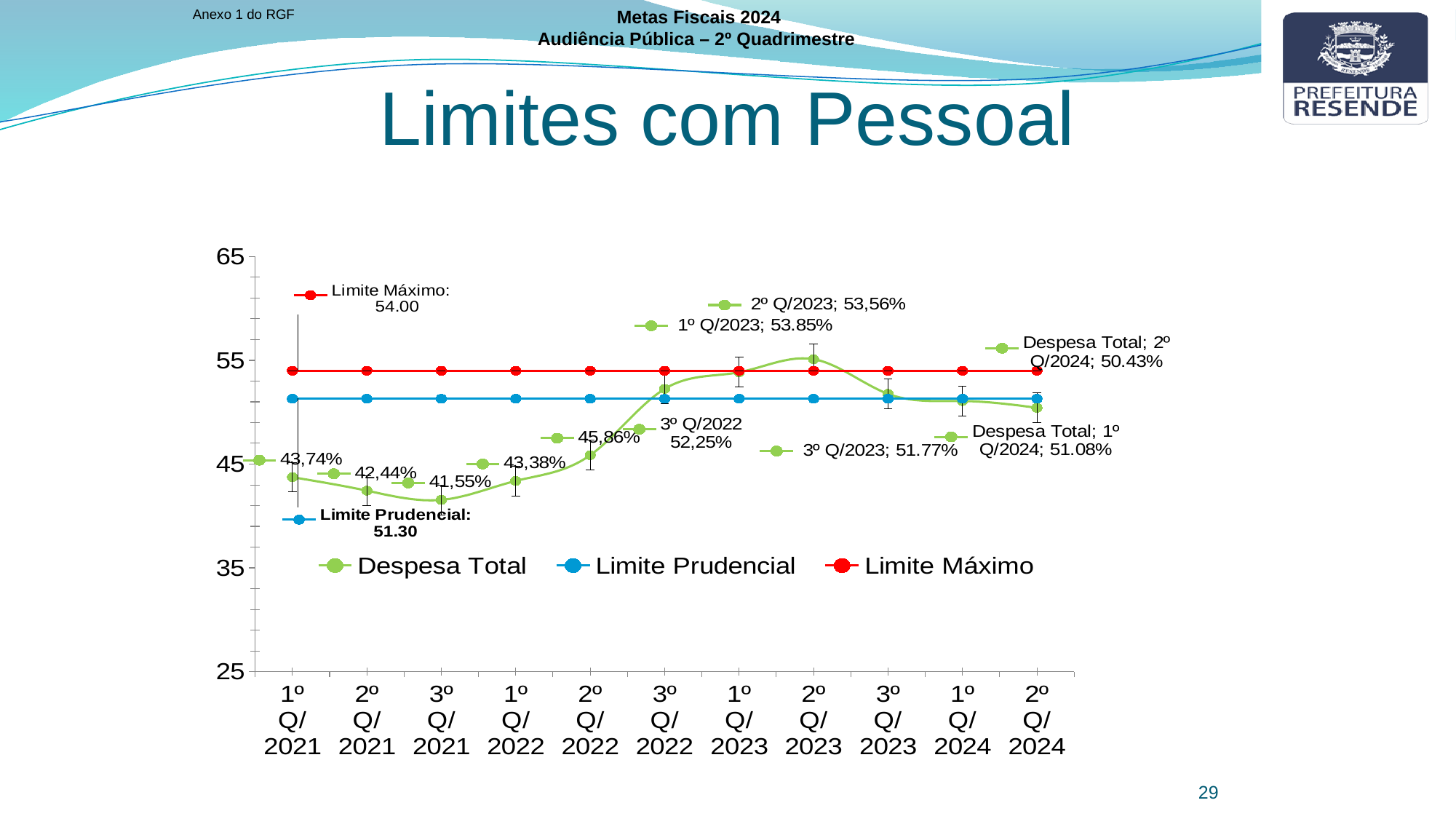
What is the difference between the Limite Máximo (54.00) and the Limite Prudencial (51.30)? 2.70 How many periods are shown on the x axis? 11 What value is shown for the Limite Máximo line? 54.00 In which period is Despesa Total at its lowest? 3º Q/2021 What value is shown for the Limite Prudencial line? 51.30 Which is larger, the Despesa Total for 2º Q/2022 or for 3º Q/2022? 3º Q/2022 What is the Despesa Total value for 1º Q/2021? 43,74% Does Despesa Total rise or fall from 3º Q/2021 to 3º Q/2022? Rise What is the Despesa Total value for 3º Q/2022? 52,25% What is the Despesa Total value for 2º Q/2024? 50.43% What kind of chart is shown on the slide? Line chart How many series does the legend list? 3